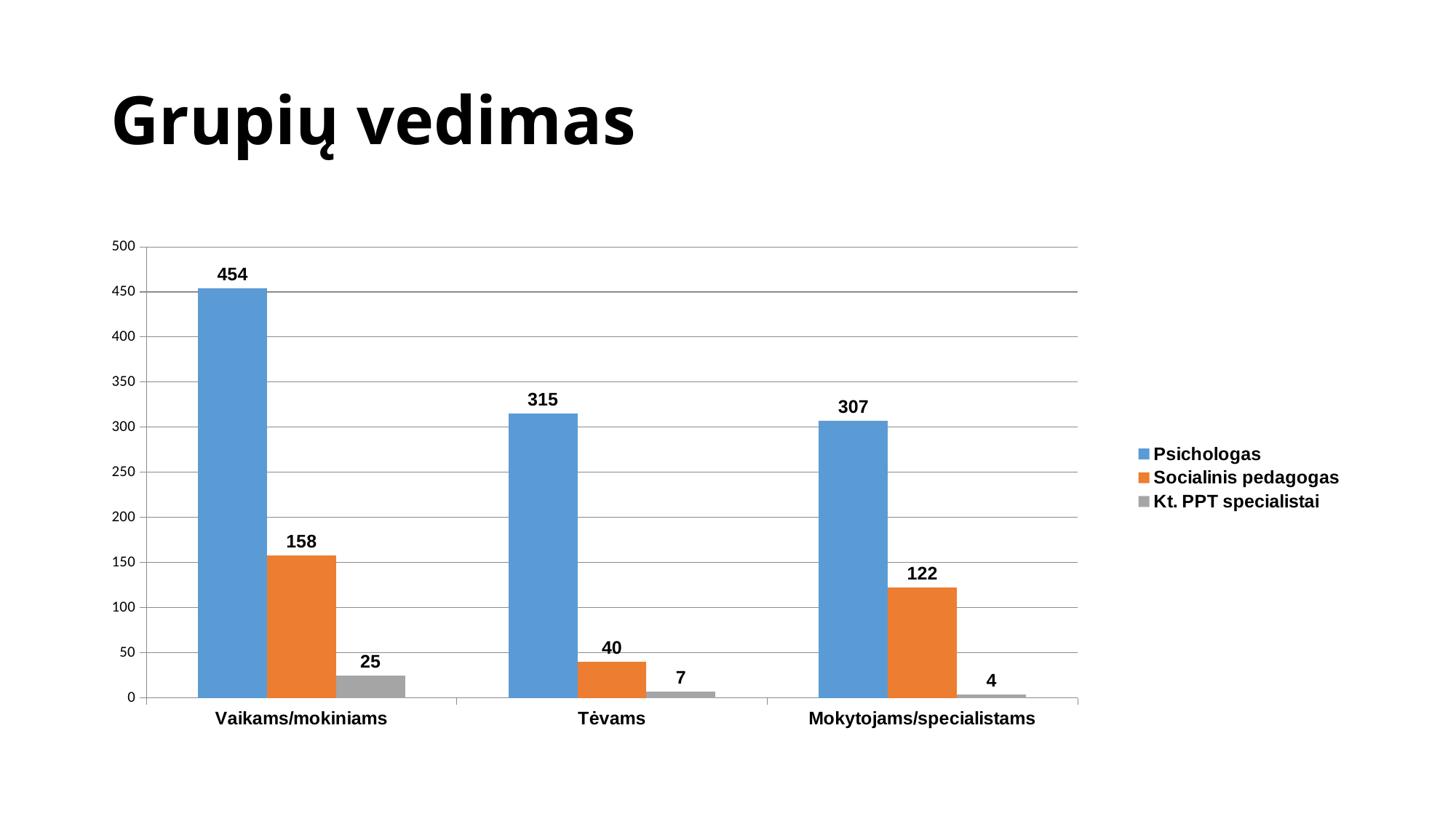
How many categories are shown on the x axis? 3 What kind of chart is shown on the slide? bar chart What is the difference between the Psichologas and Socialinis pedagogas values in the Mokytojams/specialistams category? 185 Which category has the lowest value for Socialinis pedagogas? Tėvams What is the value for Psichologas in the Vaikams/mokiniams category? 454 Which is larger: the Socialinis pedagogas value for Vaikams/mokiniams or for Mokytojams/specialistams? Vaikams/mokiniams What is the value for Socialinis pedagogas in the Tėvams category? 40 Is the value for Psichologas in the Tėvams category greater or less than 300? greater Which category has the highest value for Psichologas? Vaikams/mokiniams How many series does the legend list? 3 What is the value for Kt. PPT specialistai in the Mokytojams/specialistams category? 4 What is the title of the slide? Grupių vedimas